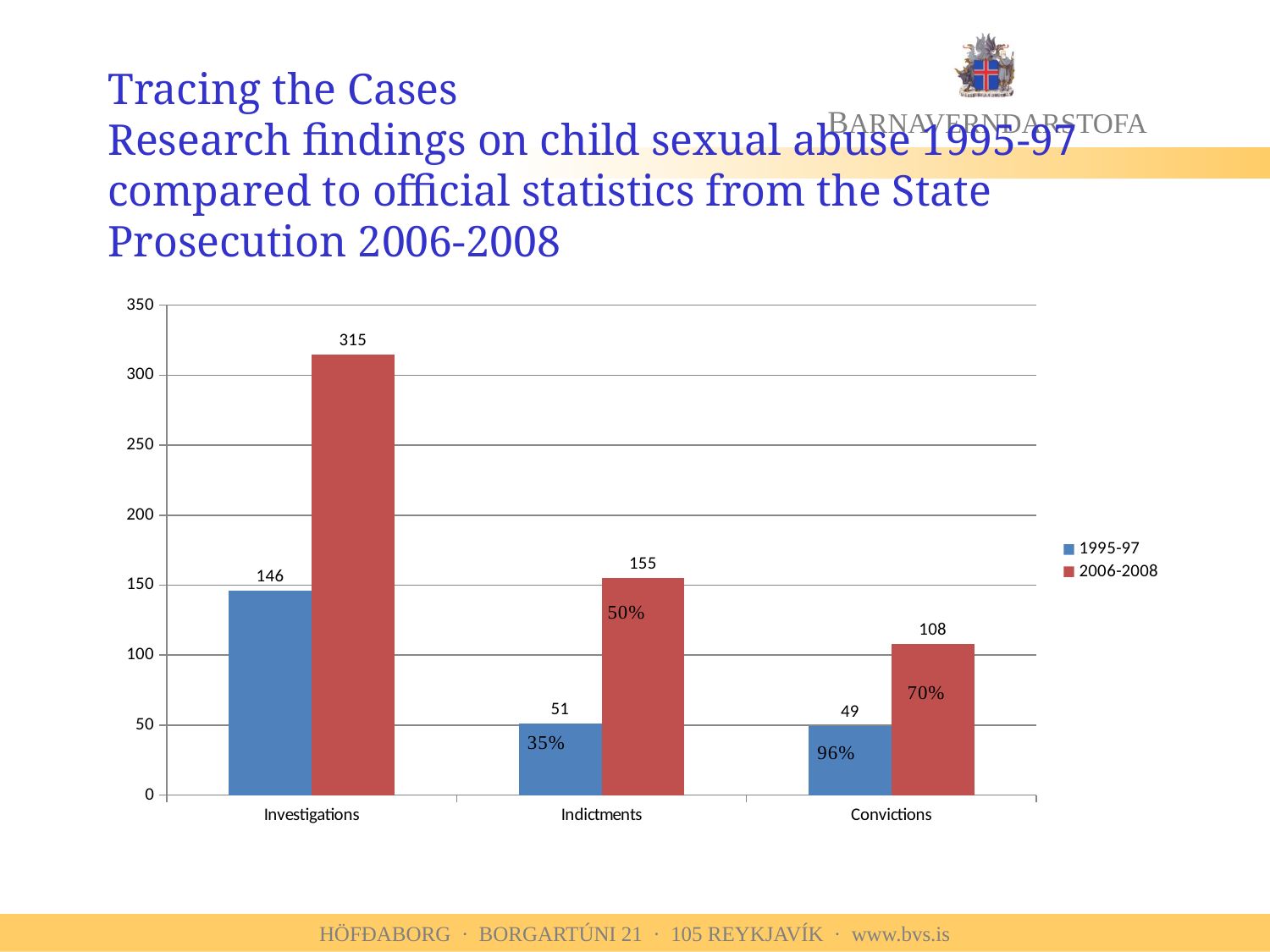
What is the value for Convictions in the 2006-2008 series? 108 What is the difference between the 2006-2008 and 1995-97 values for Investigations? 169 What is the value for Indictments in the 1995-97 series? 51 Which category has the lowest value in the 1995-97 series? Convictions How many series does the legend list? 2 What kind of chart is shown on the slide? Bar chart What is the value for Investigations in the 2006-2008 series? 315 What is the difference between the 2006-2008 and 1995-97 values for Indictments? 104 Which category has the highest value in the 2006-2008 series? Investigations Which is larger: the 1995-97 value for Convictions or the 1995-97 value for Indictments? Indictments What is the value for Investigations in the 1995-97 series? 146 How many categories are shown on the x axis? 3